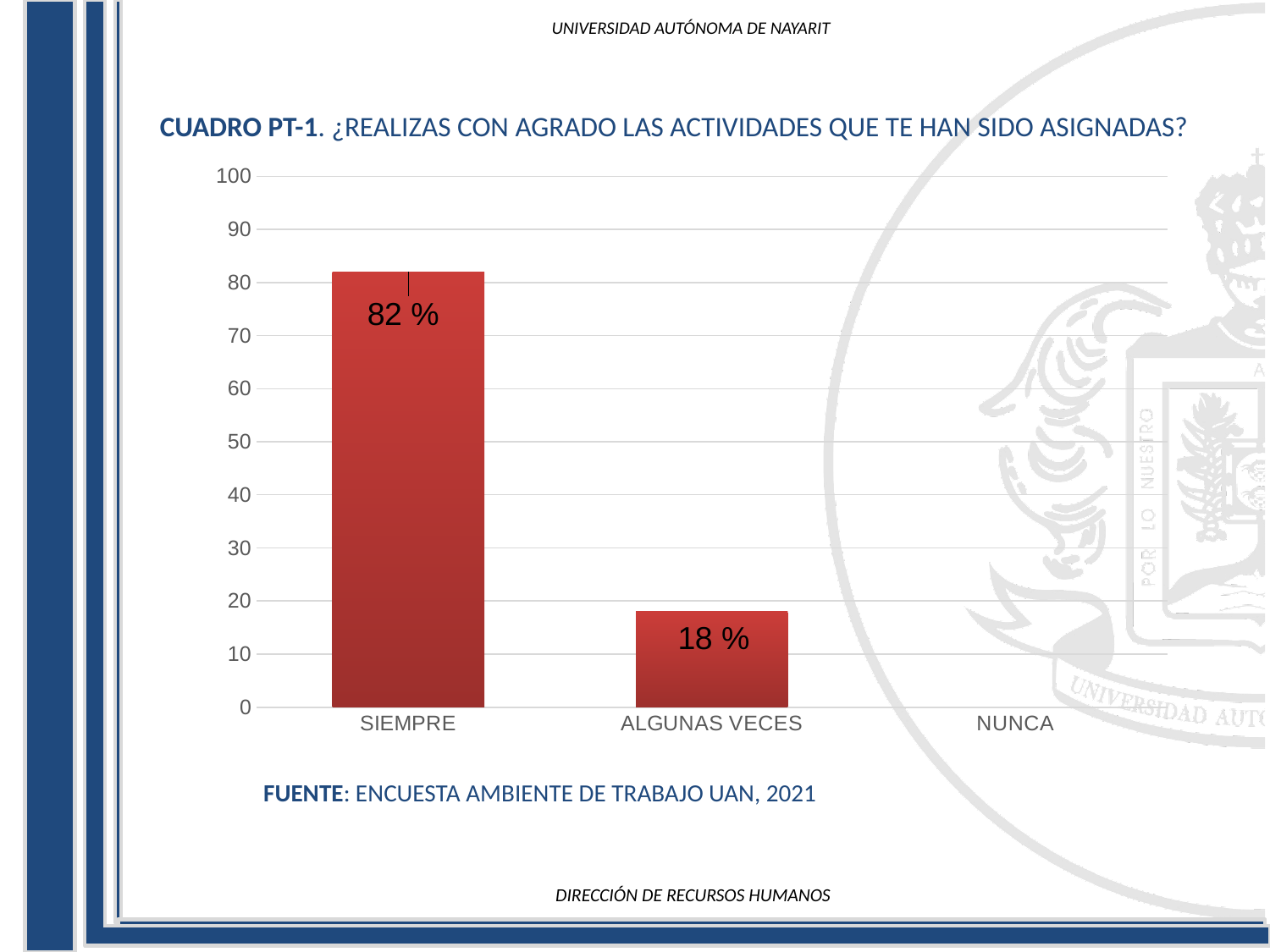
What is the difference between the values for SIEMPRE and ALGUNAS VECES? 64 % What is the value for SIEMPRE? 82 % Do the values rise or fall from left to right along the x axis? fall Is the value for ALGUNAS VECES greater or less than 20? less What kind of chart is shown on the slide? bar chart Which category has the highest value? SIEMPRE What is the source cited below the chart? ENCUESTA AMBIENTE DE TRABAJO UAN, 2021 What is the value for ALGUNAS VECES? 18 % Is the value for SIEMPRE greater or less than 50? greater Which is larger, the value for SIEMPRE or the value for ALGUNAS VECES? SIEMPRE How many categories are shown on the x axis? 3